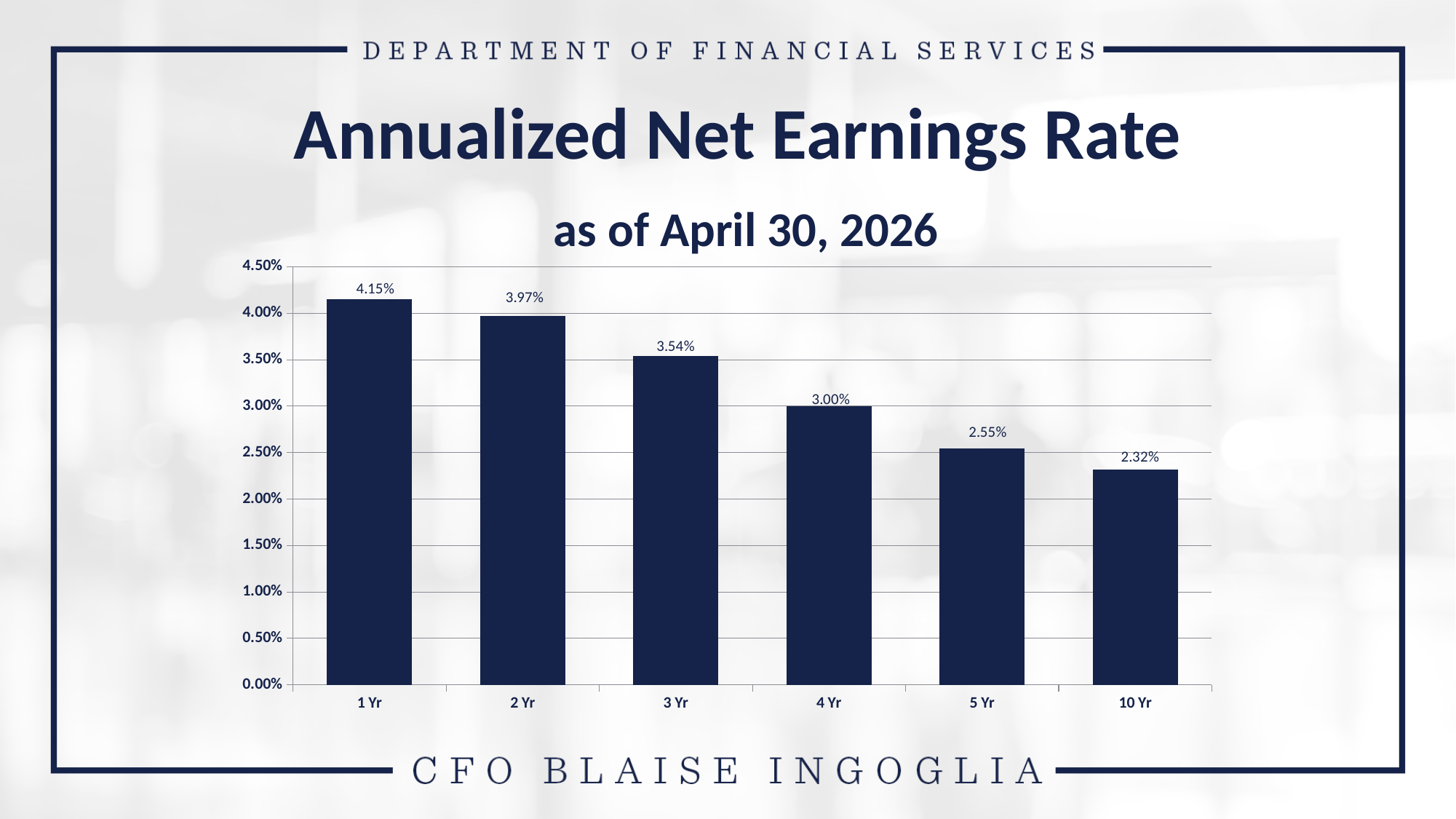
Which period has the lowest annualized net earnings rate? 10 Yr What is the annualized net earnings rate for 5 Yr? 2.55% What is the annualized net earnings rate for 1 Yr? 4.15% What is the annualized net earnings rate for 10 Yr? 2.32% Do the annualized net earnings rates rise or fall from 1 Yr to 10 Yr? Fall Which is larger, the 2 Yr rate or the 4 Yr rate? 2 Yr What is the difference between the 2 Yr and 4 Yr annualized net earnings rates? 0.97% What is the annualized net earnings rate for 3 Yr? 3.54% What is the difference between the 1 Yr and 10 Yr annualized net earnings rates? 1.83% Which period has the highest annualized net earnings rate? 1 Yr How many periods are shown on the chart? 6 What kind of chart is shown on the slide? Bar chart